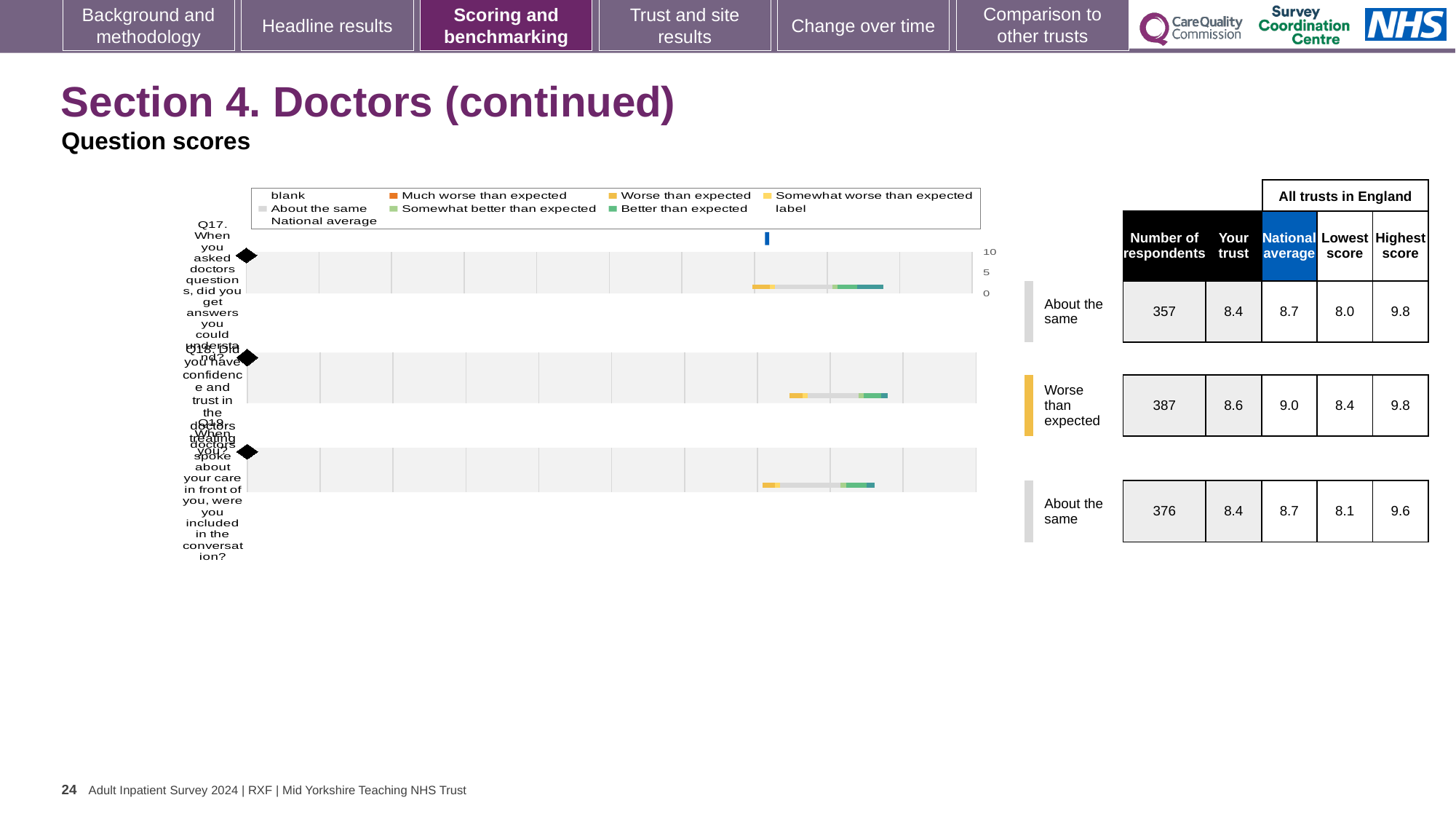
What is the 'Your trust' score for Q17 (When you asked doctors questions, did you get answers you could understand?)? 8.4 What benchmark category is shown next to the Q18 chart? Worse than expected What is the national average score for Q18 (Did you have confidence and trust in the doctors treating you?)? 9.0 What is the maximum tick value shown on the chart's score axis? 10 How many respondents answered Q19 (When doctors spoke about your care in front of you, were you included in the conversation?)? 376 Which is larger, the highest score for Q17 or the highest score for Q19? Q17 What is the lowest score among all trusts in England for Q17? 8.0 What kind of chart is used to show the question scores for Q17, Q18 and Q19? bar chart What is the difference between the national average and the 'Your trust' score for Q18? 0.4 Which question has the lowest 'Lowest score' across all trusts in England? Q17 Which question has the highest 'Your trust' score? Q18 How many questions (Q17, Q18, Q19) have a chart row on this slide? 3